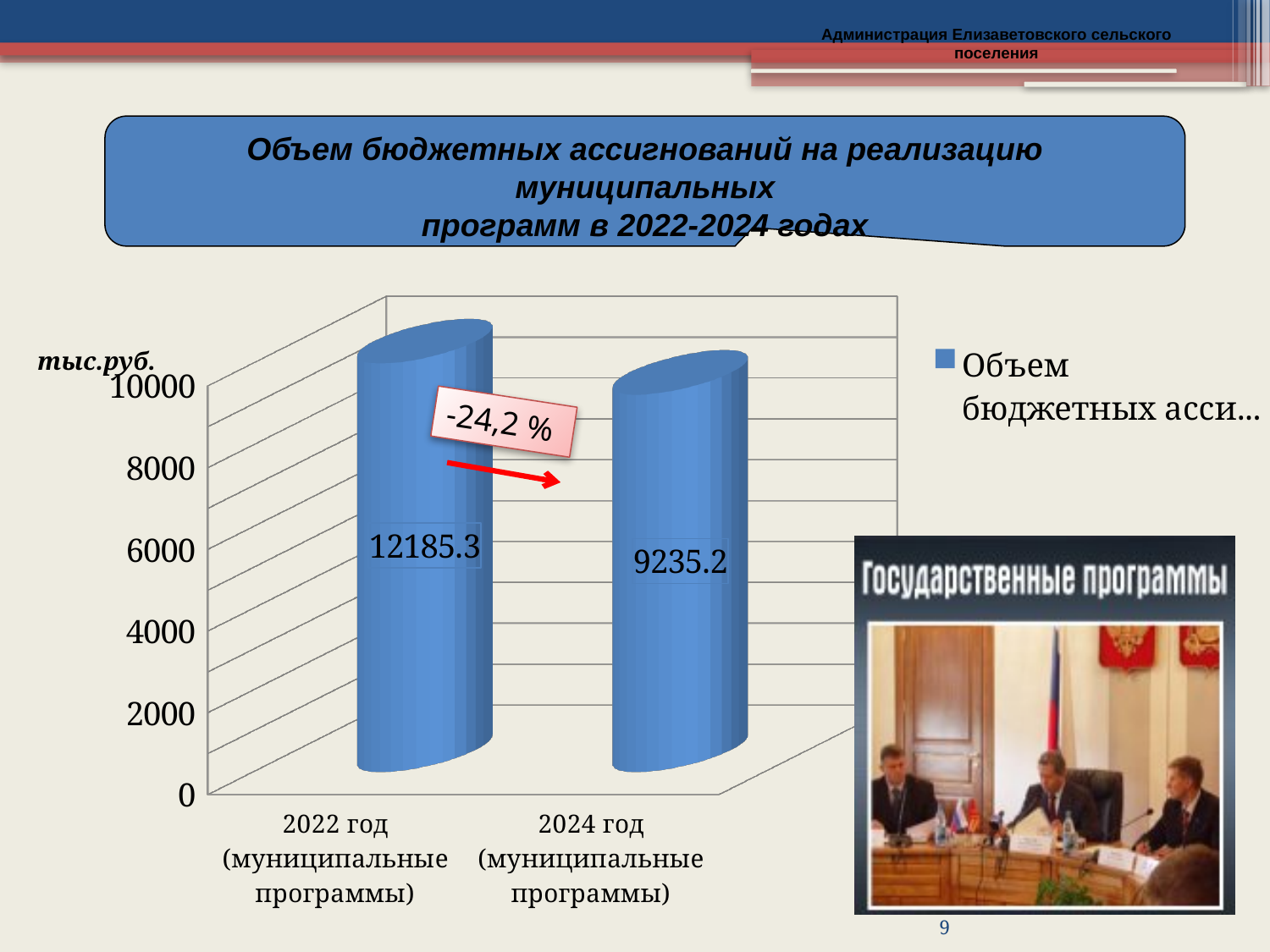
What percentage change is shown in the annotation between the two bars? -24,2 % What is the value for 2024 год (муниципальные программы)? 9235.2 Is the value for 2022 год greater or less than 10000? greater What is the value for 2022 год (муниципальные программы)? 12185.3 How many categories are shown on the x axis? 2 Is the value for 2022 год larger or smaller than the value for 2024 год? larger What is the difference between the 2022 and 2024 values? 2950.1 Do the values rise or fall from 2022 to 2024? fall Is the value for 2024 год greater or less than 10000? less Which year has the higher value of budget allocations? 2022 год Which year has the lower value of budget allocations? 2024 год What kind of chart is shown on the slide? bar chart